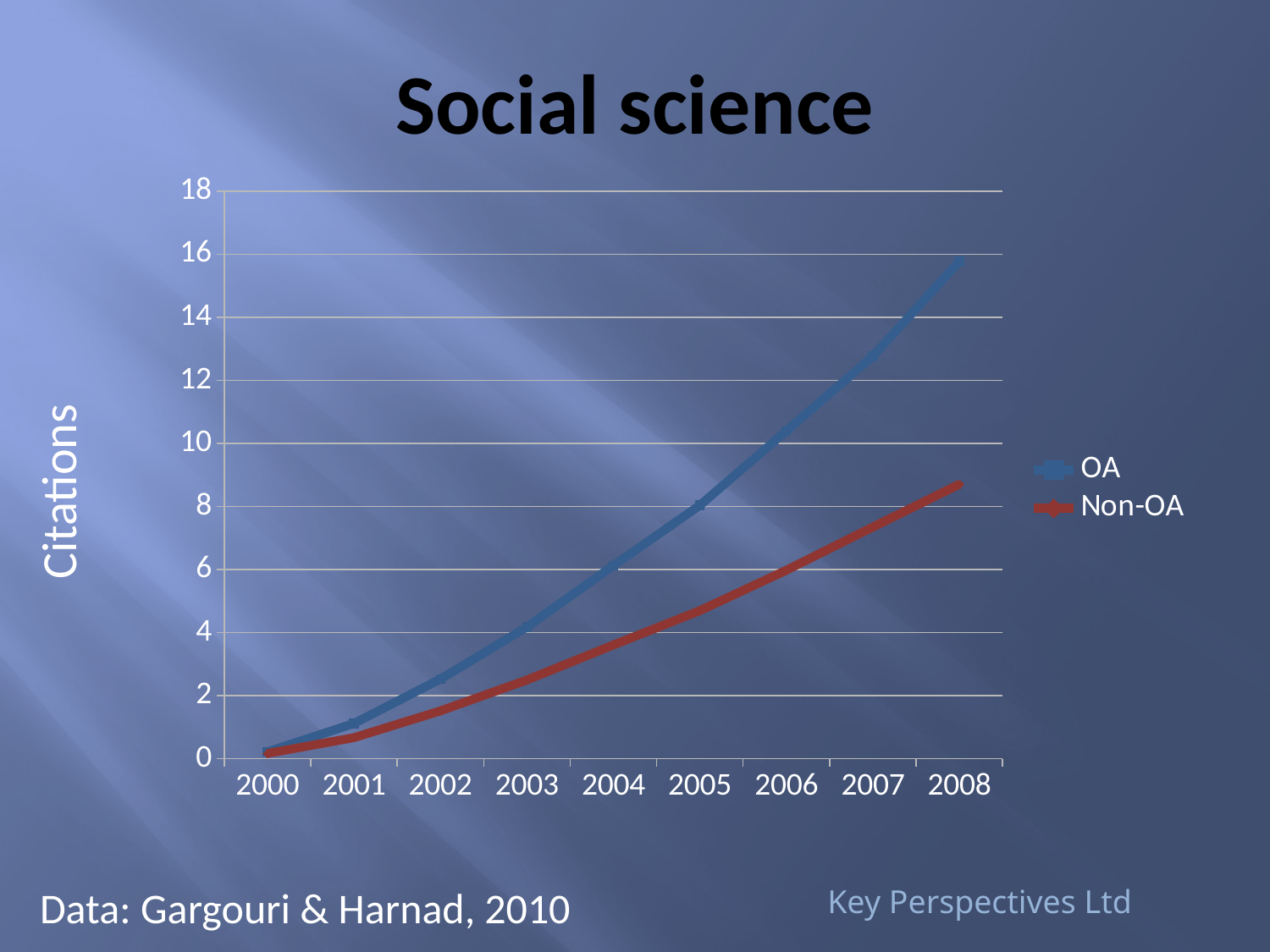
Is the Non-OA value for 2008 greater or less than 10? less What is the label on the y axis of the chart? Citations How many years are shown on the x axis? 9 Do the OA citations rise or fall from 2000 to 2008? rise Is the Non-OA value for 2004 greater or less than 4? less How many series does the legend list? 2 In which year is the OA series at its highest? 2008 In which year is the Non-OA series at its lowest? 2000 In 2008, which series has the higher value, OA or Non-OA? OA Is the OA value for 2008 greater or less than 14? greater What kind of chart is shown on the slide? line chart